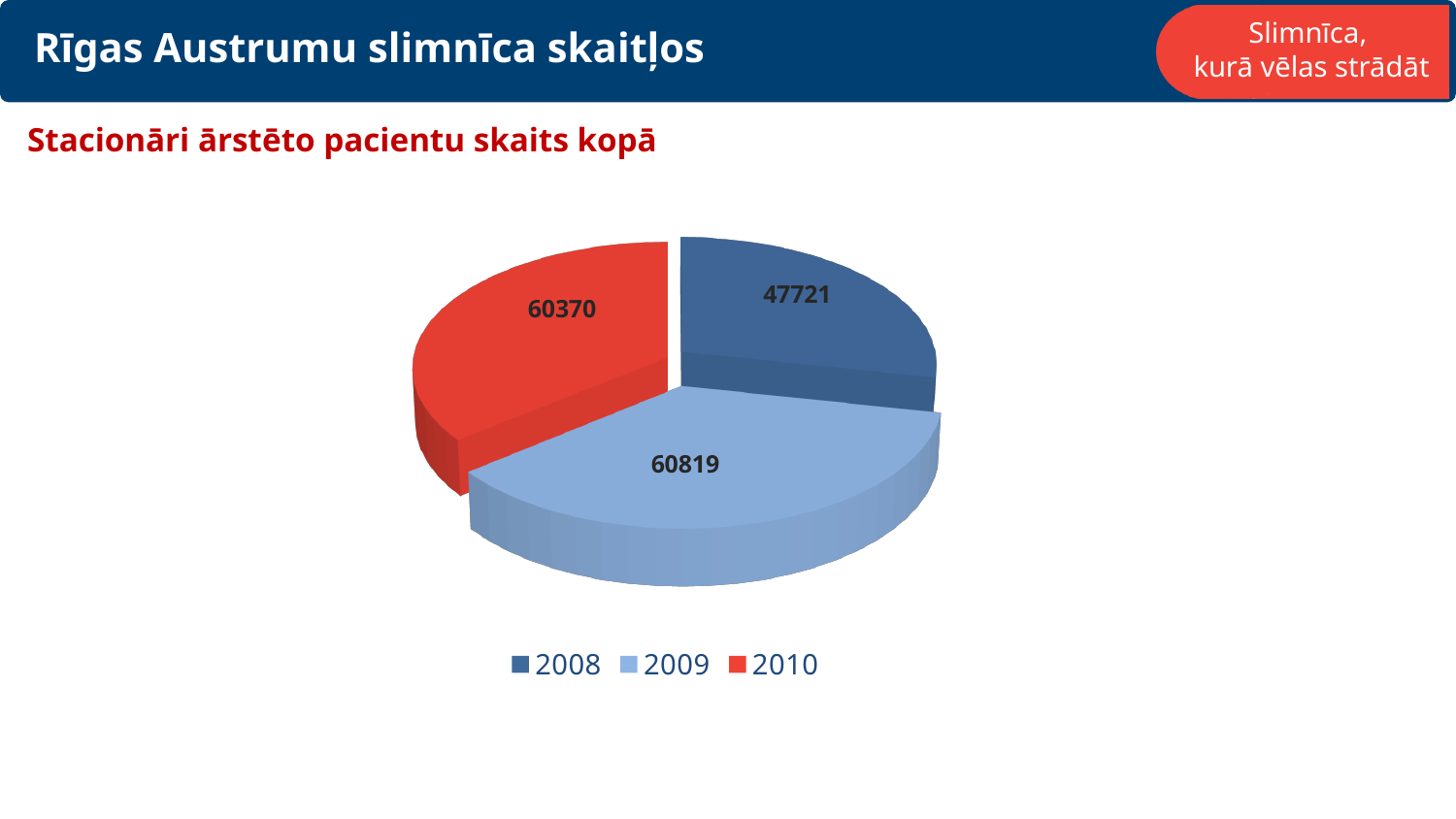
Which year has the highest value? 2009 Which year has the lowest value? 2008 What is the value for 2010? 60370 Which colour represents 2010 in the chart? Red What is the value for 2008? 47721 How many series does the legend list? 3 What is the value for 2009? 60819 Which is larger, the value for 2009 or the value for 2010? 2009 What kind of chart is shown on the slide? Pie chart What is the title of the chart? Stacionāri ārstēto pacientu skaits kopā How many slices does the pie chart have? 3 What is the difference between the values for 2009 and 2008? 13098